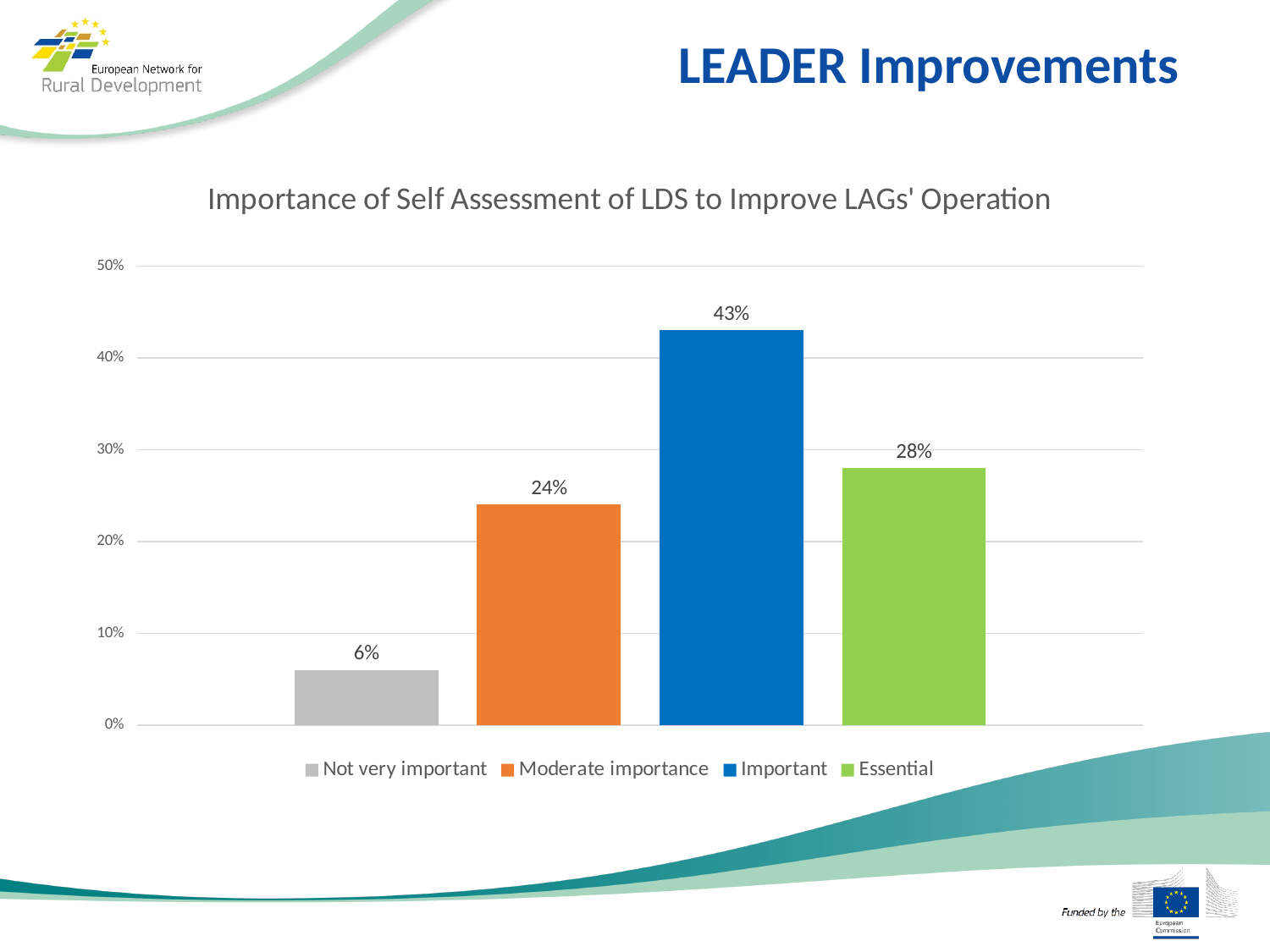
What kind of chart is shown on the slide? Bar chart What is the title of the chart? Importance of Self Assessment of LDS to Improve LAGs' Operation What is the value for "Not very important"? 6% How many entries does the legend list? 4 What is the difference between the values for "Important" and "Essential"? 15% Is the value for "Moderate importance" greater or less than 20%? greater Which is larger, the value for "Moderate importance" or the value for "Essential"? Essential What is the value for "Essential"? 28% How many categories are shown in the chart? 4 What is the value for "Important"? 43% Which category has the lowest value? Not very important Which category has the highest value? Important